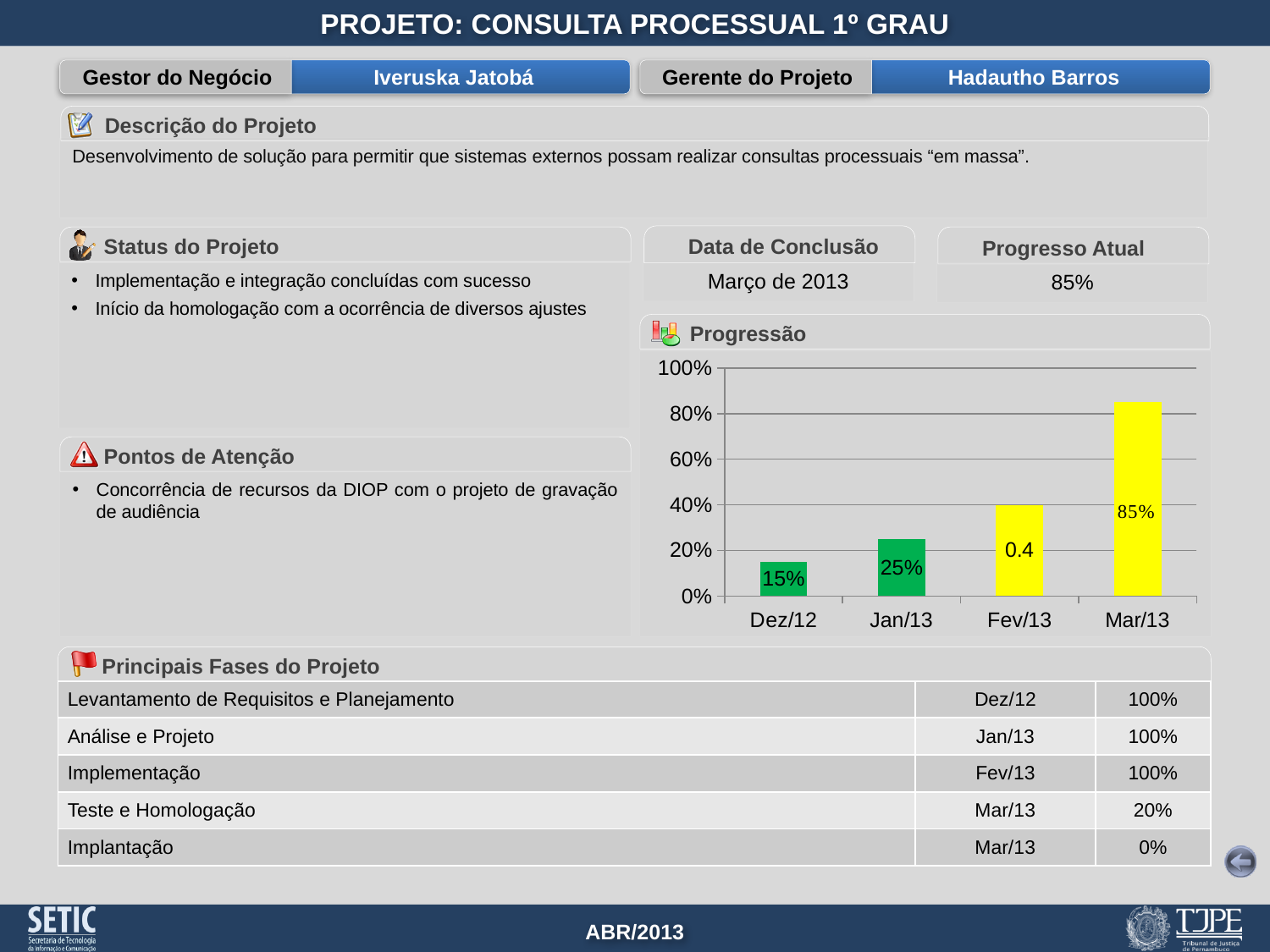
In the "Progressão" chart, which month has the highest value? Mar/13 In the "Progressão" chart, which month has the lowest value? Dez/12 In the "Progressão" chart, what is the difference between the values for Mar/13 and Dez/12? 70% How many months are shown on the x axis of the "Progressão" chart? 4 In the "Progressão" chart, what is the difference between the values for Jan/13 and Dez/12? 10% What type of chart is shown under "Progressão"? bar chart In the "Progressão" chart, which is larger, the value for Fev/13 or the value for Jan/13? Fev/13 In the "Progressão" chart, what data label is printed on the Fev/13 bar? 0.4 In the "Progressão" chart, what is the value for Jan/13? 25% In the "Progressão" chart, what is the value for Mar/13? 85% In the "Progressão" chart, what is the value for Dez/12? 15% In the "Progressão" chart, do the values rise or fall from Dez/12 to Mar/13? rise